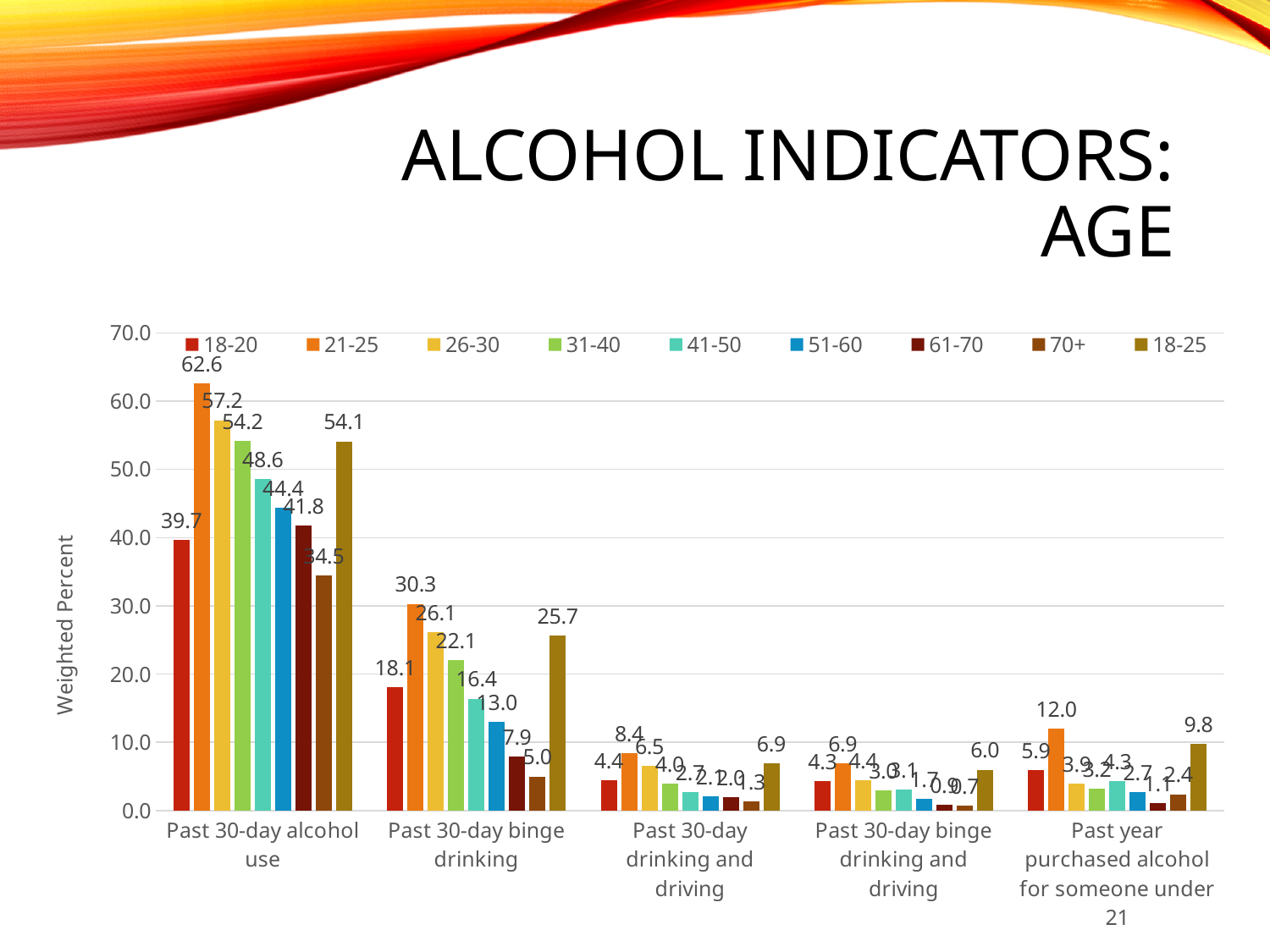
How many indicator categories are shown on the x axis? 5 What is the label of the y axis? Weighted Percent For Past 30-day binge drinking, which is larger: the 26-30 value or the 18-25 value? 26-30 Is the value for the 41-50 age group for Past 30-day alcohol use greater or less than 40.0? greater What is the value for the 21-25 age group for Past 30-day alcohol use? 62.6 Which age group has the highest value for Past 30-day alcohol use? 21-25 What is the value for the 21-25 age group for Past year purchased alcohol for someone under 21? 12.0 What is the difference between the 21-25 and 18-20 values for Past 30-day alcohol use? 22.9 Which age group has the lowest value for Past 30-day binge drinking? 70+ What kind of chart is shown on the slide? Bar chart How many age groups does the legend list? 9 What is the value for the 18-25 age group for Past 30-day binge drinking? 25.7